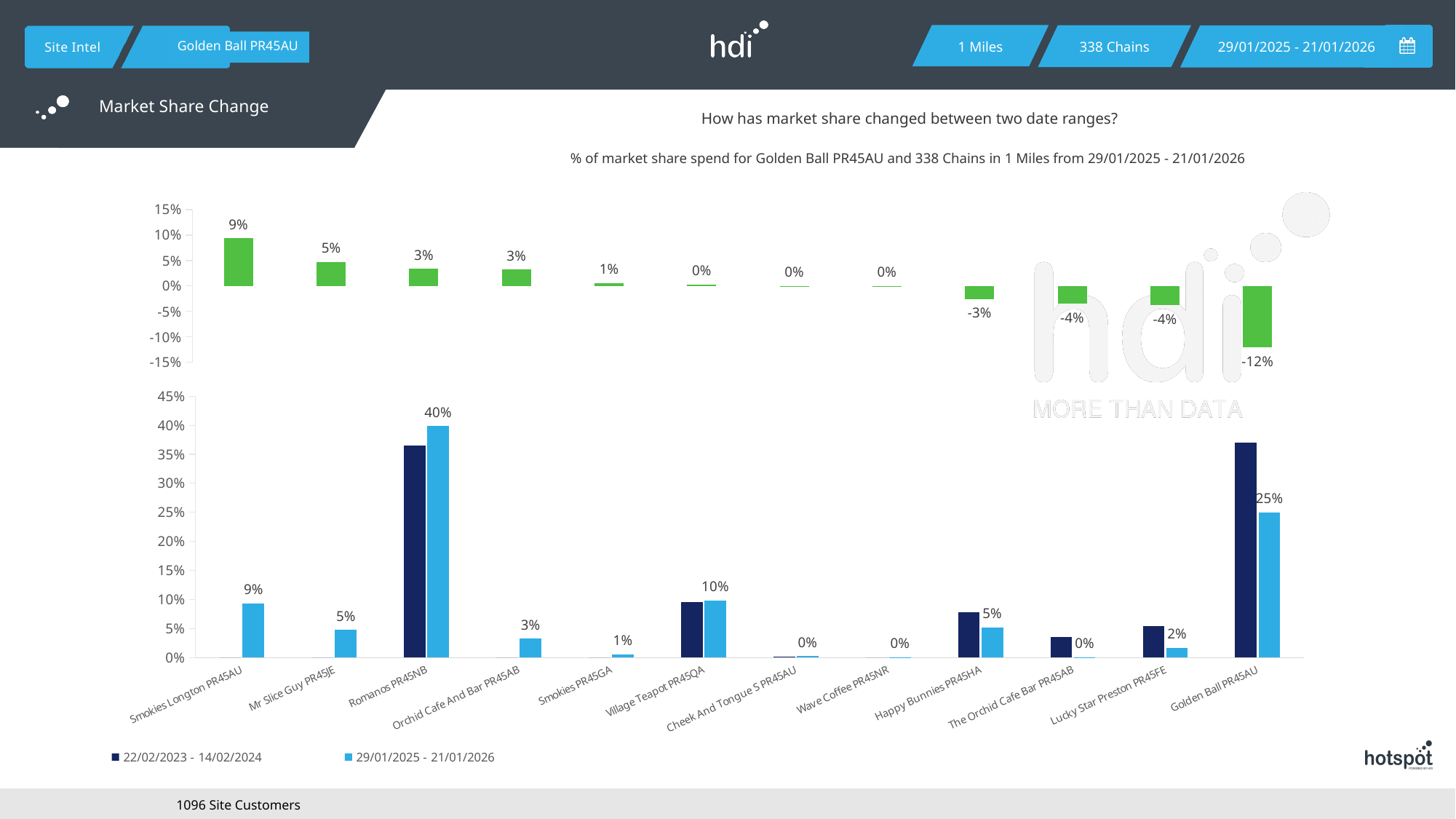
How many series does the legend of the bottom chart list? 2 In the top chart (market share change), what is the value for Mr Slice Guy PR45JE? 5% In the bottom chart, what is the value for Romanos PR45NB in the 29/01/2025 - 21/01/2026 series? 40% What kind of chart is the bottom chart? bar chart In the bottom chart, what is the value for Golden Ball PR45AU in the 29/01/2025 - 21/01/2026 series? 25% How many categories are plotted in the bottom chart? 12 In the top chart (market share change), what is the value for Golden Ball PR45AU? -12% In the bottom chart, which is larger in the 29/01/2025 - 21/01/2026 series: Village Teapot PR45QA or Happy Bunnies PR45HA? Village Teapot PR45QA In the bottom chart, what is the difference between Romanos PR45NB and Golden Ball PR45AU in the 29/01/2025 - 21/01/2026 series? 15% In the top chart (market share change), which category has the lowest value? Golden Ball PR45AU In the bottom chart, is the value for Golden Ball PR45AU in the 22/02/2023 - 14/02/2024 series greater or less than 35%? greater In the top chart (market share change), which category has the highest value? Smokies Longton PR45AU